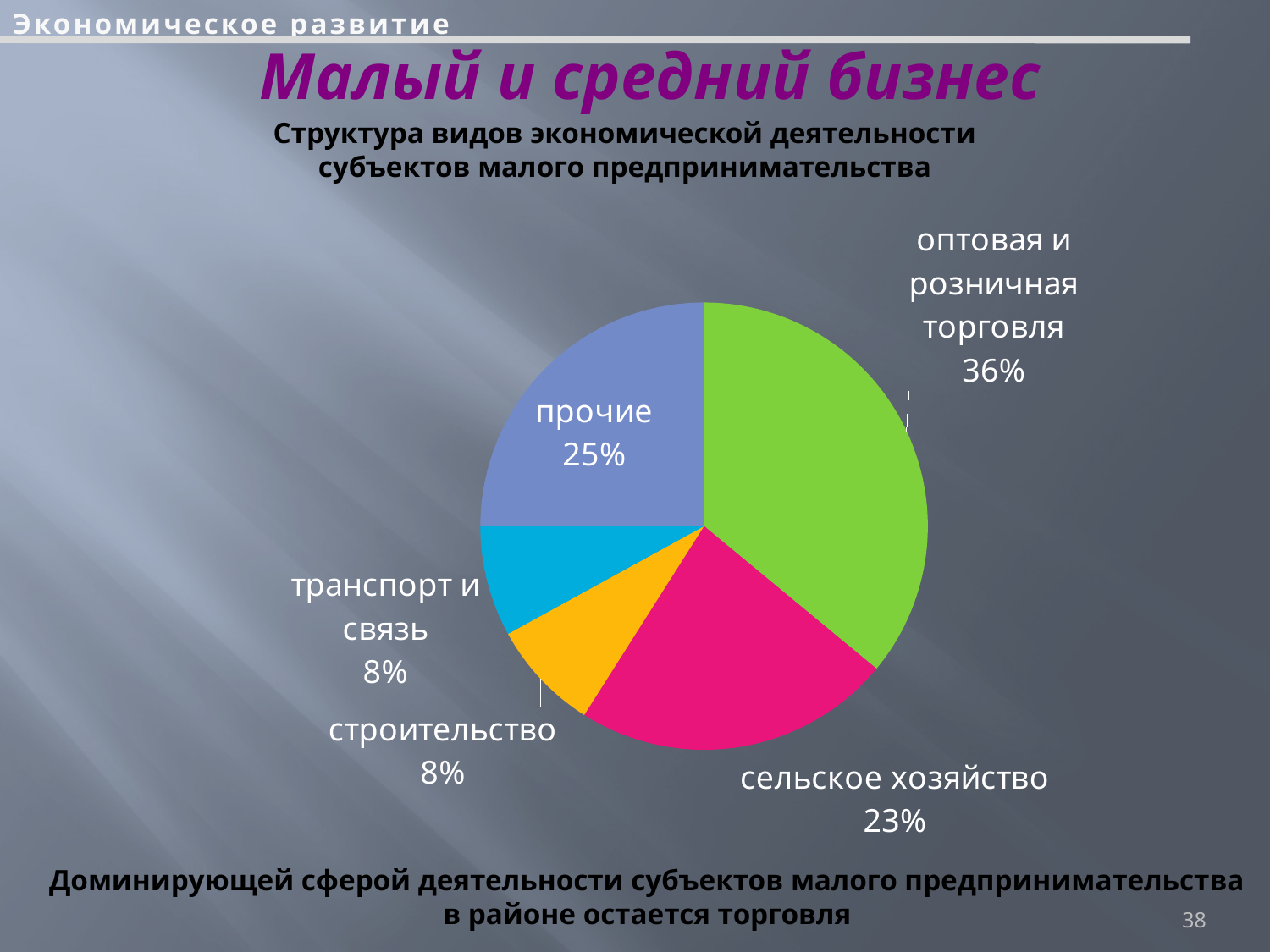
What colour is the slice for "сельское хозяйство"? pink (magenta) Which category has the largest share of the pie? оптовая и розничная торговля What is the combined share of "строительство" and "транспорт и связь"? 16% Which is larger: the share for "прочие" or the share for "сельское хозяйство"? прочие How many slices does the pie chart have? 5 What share of the pie is labelled "транспорт и связь"? 8% What is the difference in percentage points between "оптовая и розничная торговля" and "сельское хозяйство"? 13 What kind of chart is shown on the slide? pie chart What share of the pie is labelled "оптовая и розничная торговля"? 36% What share of the pie is labelled "сельское хозяйство"? 23% What share of the pie is labelled "прочие"? 25% What share of the pie is labelled "строительство"? 8%